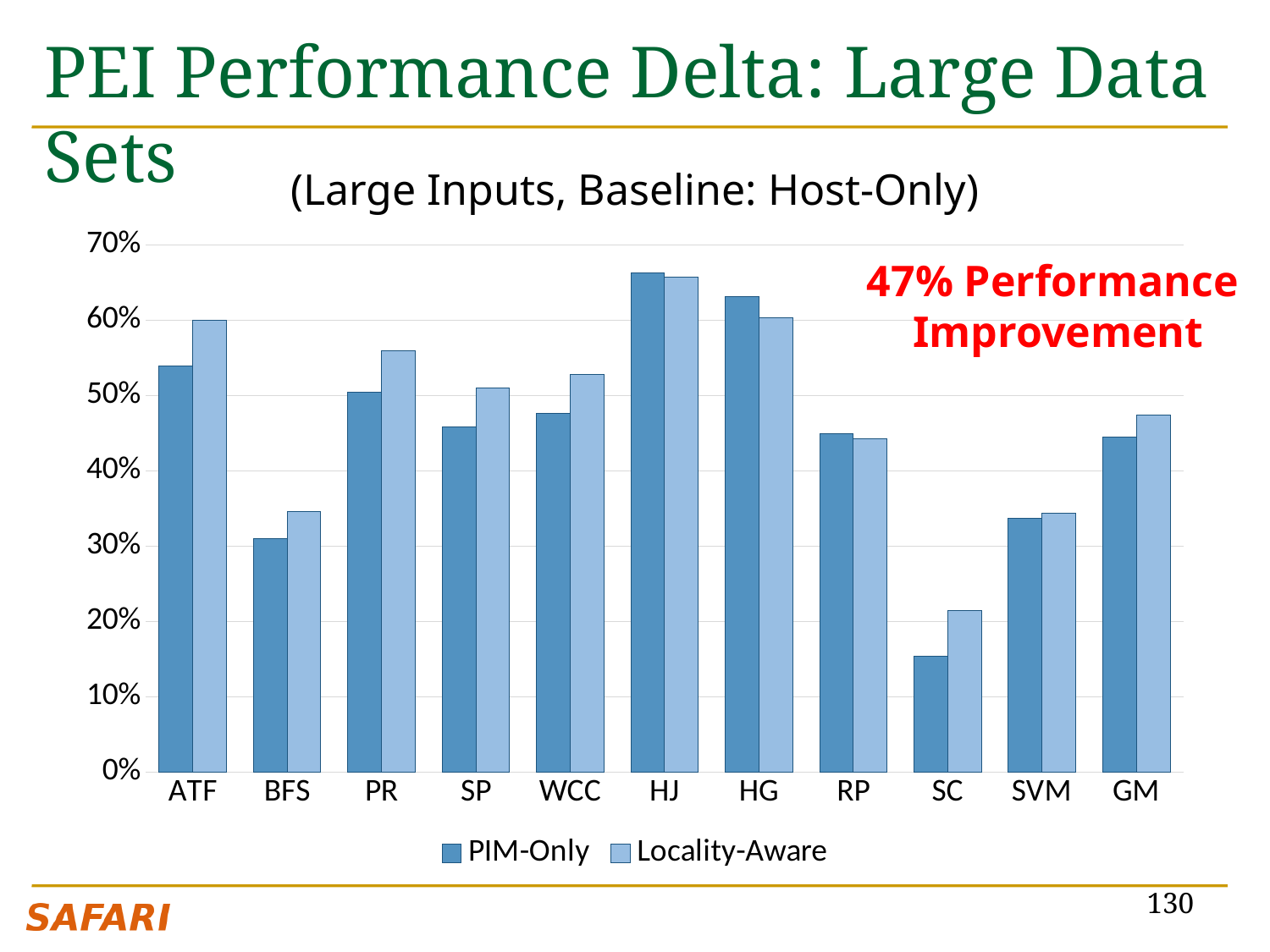
For HG, which series has the larger value, PIM-Only or Locality-Aware? PIM-Only How many categories are shown on the x axis? 11 What performance improvement is called out in the red annotation on the chart? 47% Performance Improvement Which category has the lowest PIM-Only value? SC For ATF, which series has the larger value, PIM-Only or Locality-Aware? Locality-Aware How many series does the legend list? 2 Is the Locality-Aware value for GM greater or less than 50%? less Is the PIM-Only value for HJ greater or less than 60%? greater What kind of chart is shown on the slide? bar chart Is the PIM-Only value for SC greater or less than 20%? less Which category has the lowest Locality-Aware value? SC Which category has the highest PIM-Only value? HJ